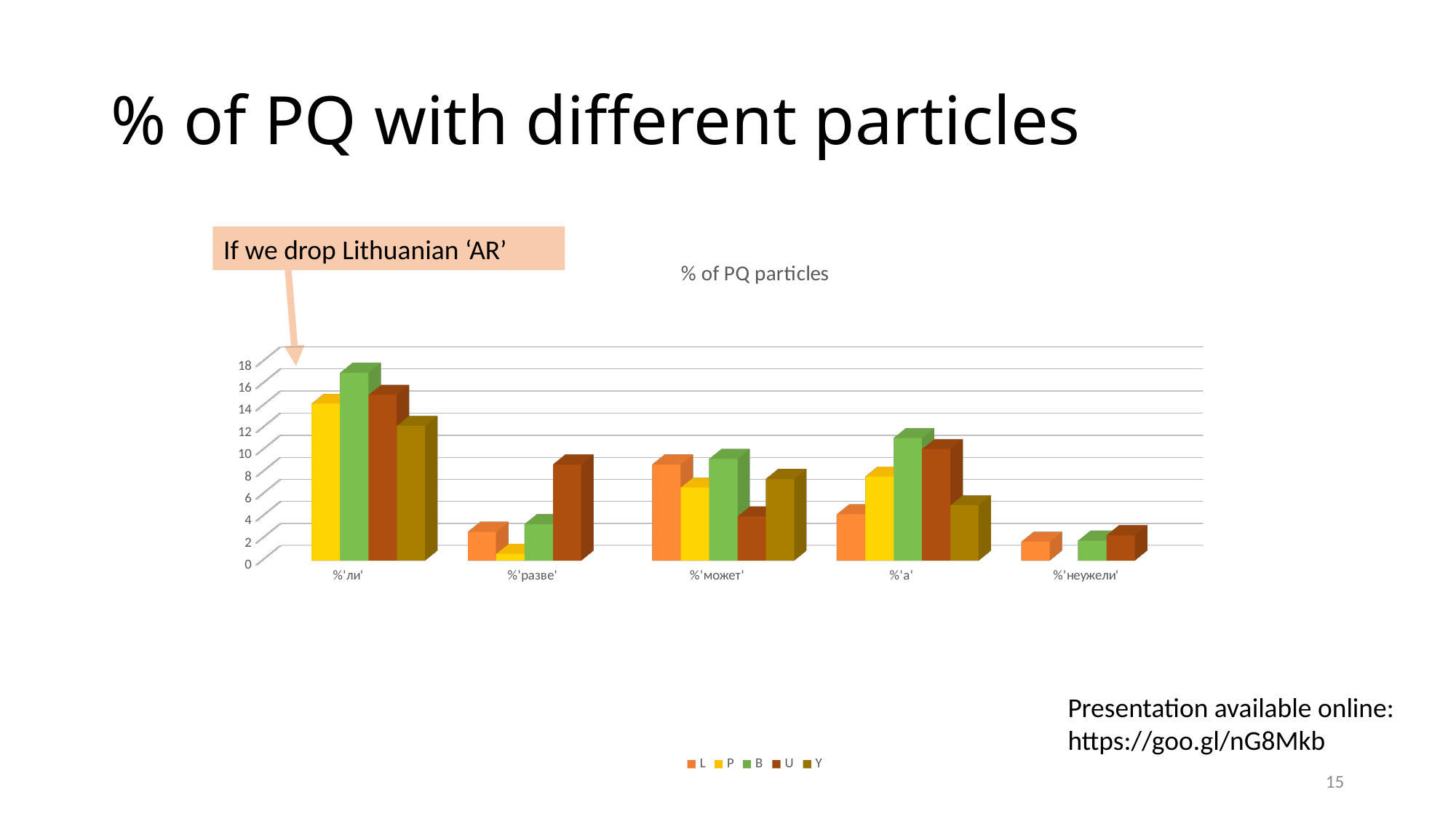
What is the title of the chart? % of PQ particles Which series has the highest value for %'разве'? U Which is larger for %'разве': series U or series B? series U How many series does the legend list? 5 Is the value of series L for %'неужели' greater or less than 4? less What kind of chart is shown on the slide? bar chart Is the value of series U for %'разве' greater or less than 6? greater Which series has the lowest value for %'ли'? Y How many categories are shown on the x axis? 5 Which is larger: series B for %'ли' or series B for %'а'? series B for %'ли' Which series has the highest value for %'ли'? B Is the value of series B for %'ли' greater or less than 14? greater